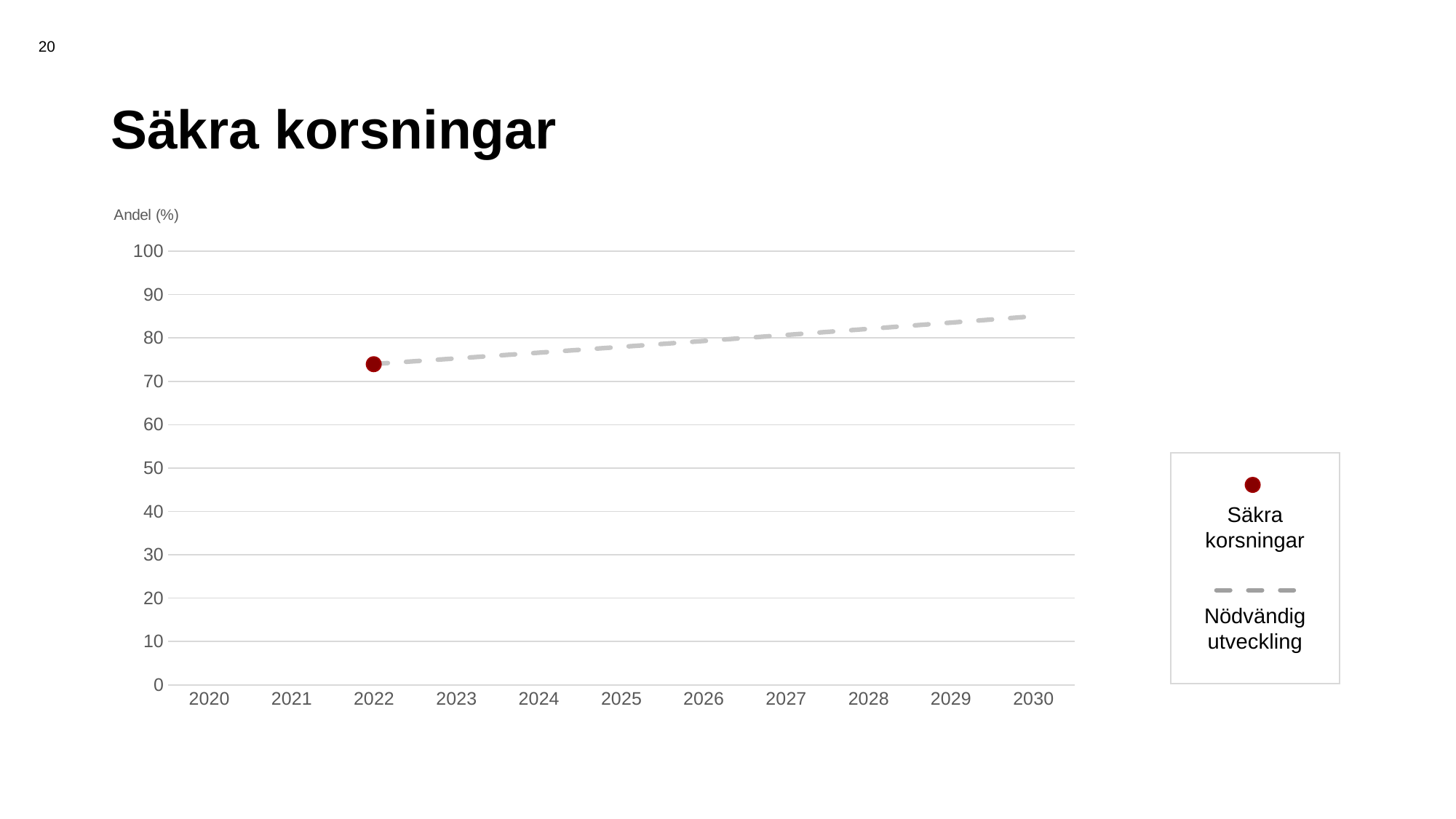
How many years are labelled on the x axis? 11 Is the value for Säkra korsningar in 2022 greater or less than 70? greater Is the value of the Nödvändig utveckling line in 2030 greater or less than 80? greater What are the two entries in the chart's legend? Säkra korsningar and Nödvändig utveckling In which year is the Säkra korsningar data point plotted? 2022 How many series does the legend list? 2 Which is larger: the Nödvändig utveckling value in 2030 or the Säkra korsningar value in 2022? Nödvändig utveckling in 2030 Is the value of the Nödvändig utveckling line in 2030 greater or less than 90? less What kind of chart is shown on the slide? Line chart Does the Nödvändig utveckling line rise or fall from 2022 to 2030? Rise What is the title of the chart on the slide? Säkra korsningar